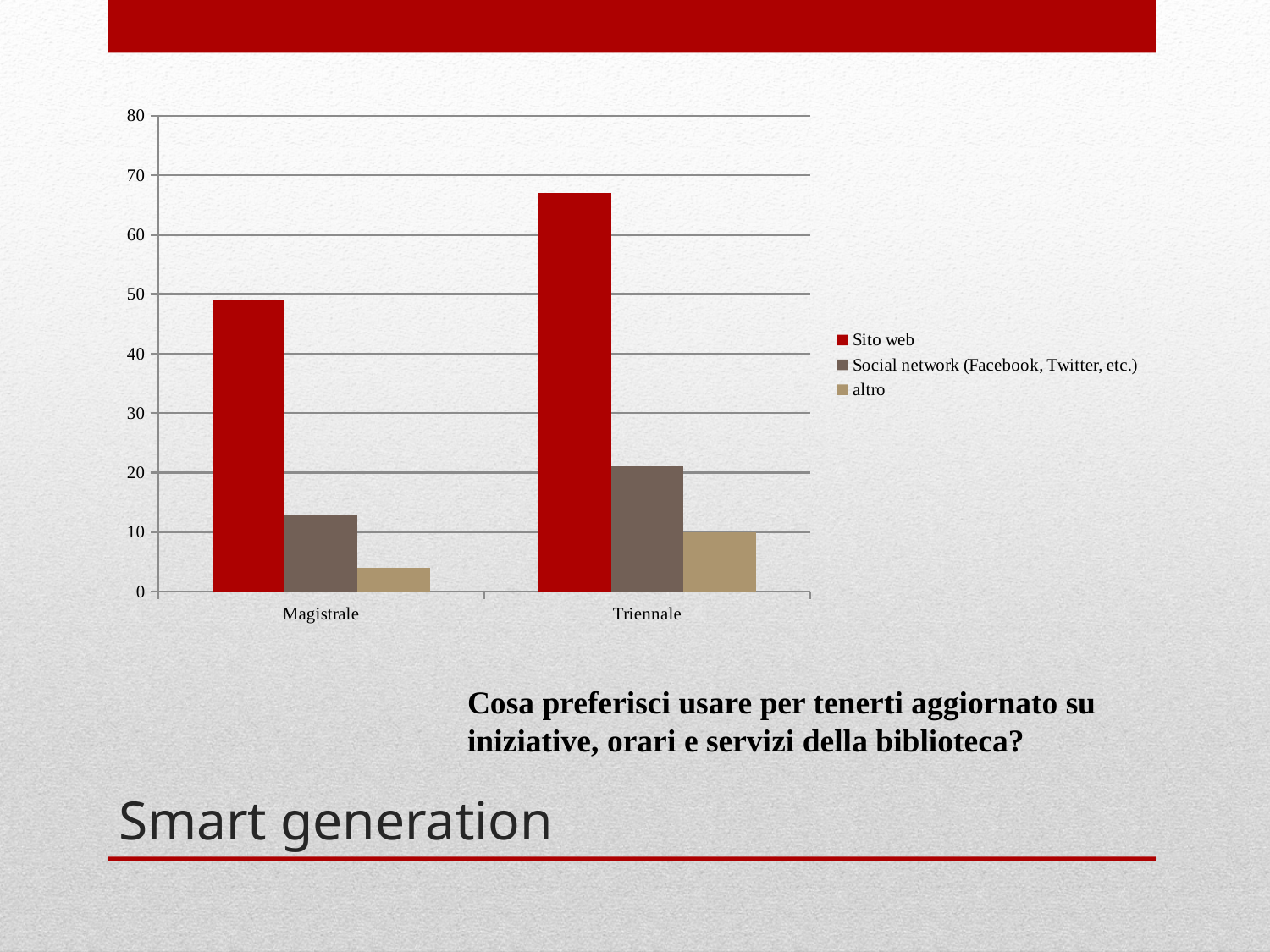
Which series has the lowest value for Magistrale? altro Which is larger: Social network (Facebook, Twitter, etc.) for Magistrale or for Triennale? Triennale Which category has the highest value for Sito web? Triennale How many series does the legend list? 3 Is the value for Sito web in Triennale greater or less than 60? greater Which series is shown in red? Sito web What is the maximum value shown on the y axis? 80 Is the value for altro in Magistrale greater or less than 10? less How many categories are shown on the x axis? 2 What kind of chart is shown on the slide? bar chart